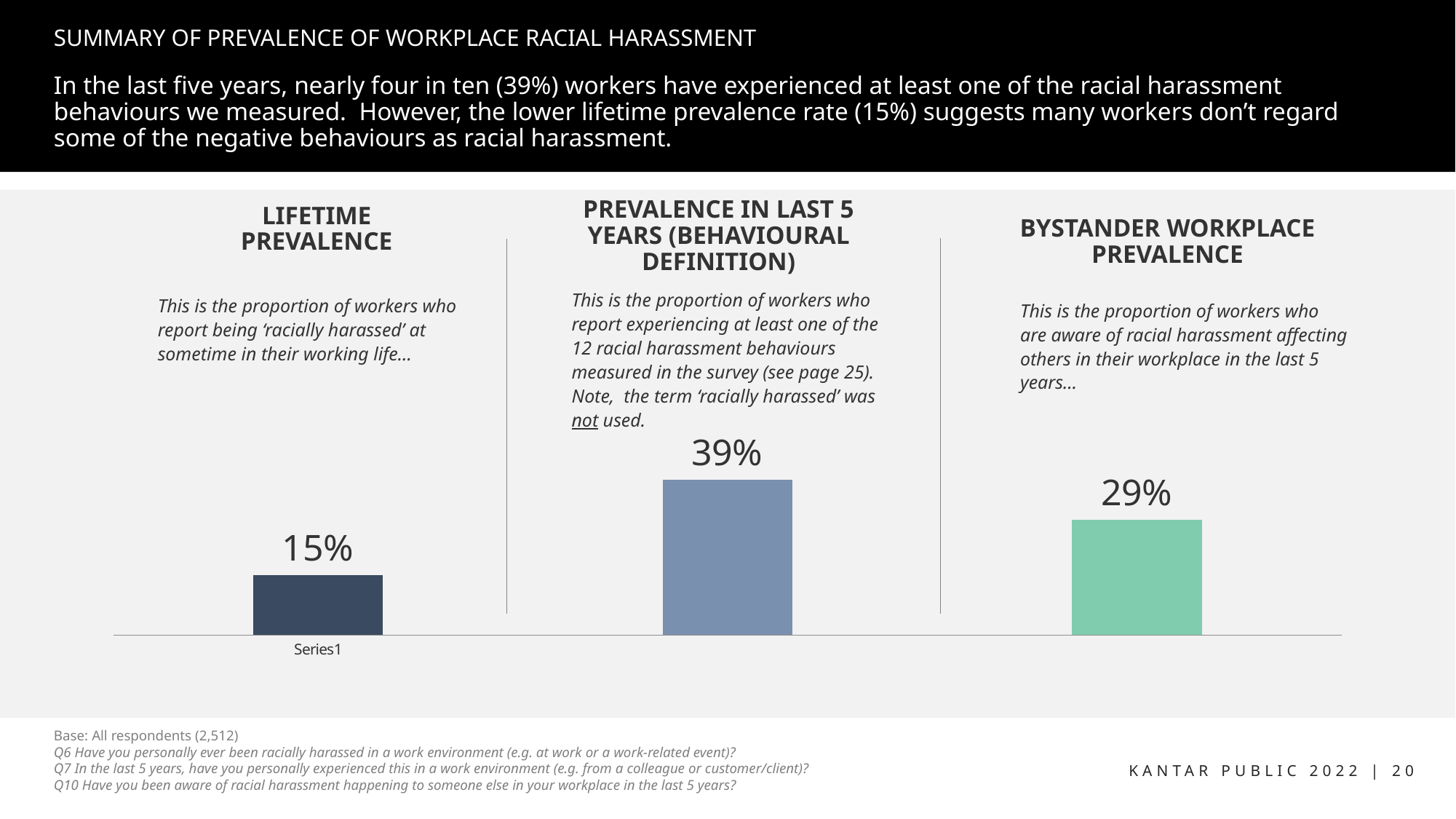
What is the difference between the Prevalence in Last 5 Years value and the Lifetime Prevalence value? 24% What colour is the bar for Bystander Workplace Prevalence? Green Which of the three prevalence measures has the highest value? Prevalence in Last 5 Years (Behavioural Definition) How many bars are plotted on the slide? 3 What is the value shown for Prevalence in Last 5 Years (Behavioural Definition)? 39% Which of the three prevalence measures has the lowest value? Lifetime Prevalence What is the difference between the Bystander Workplace Prevalence value and the Lifetime Prevalence value? 14% What is the value shown for Lifetime Prevalence? 15% What is the value shown for Bystander Workplace Prevalence? 29% Which is larger: Prevalence in Last 5 Years or Bystander Workplace Prevalence? Prevalence in Last 5 Years Which is larger: Bystander Workplace Prevalence or Lifetime Prevalence? Bystander Workplace Prevalence What kind of chart is used to show the prevalence values? Bar chart